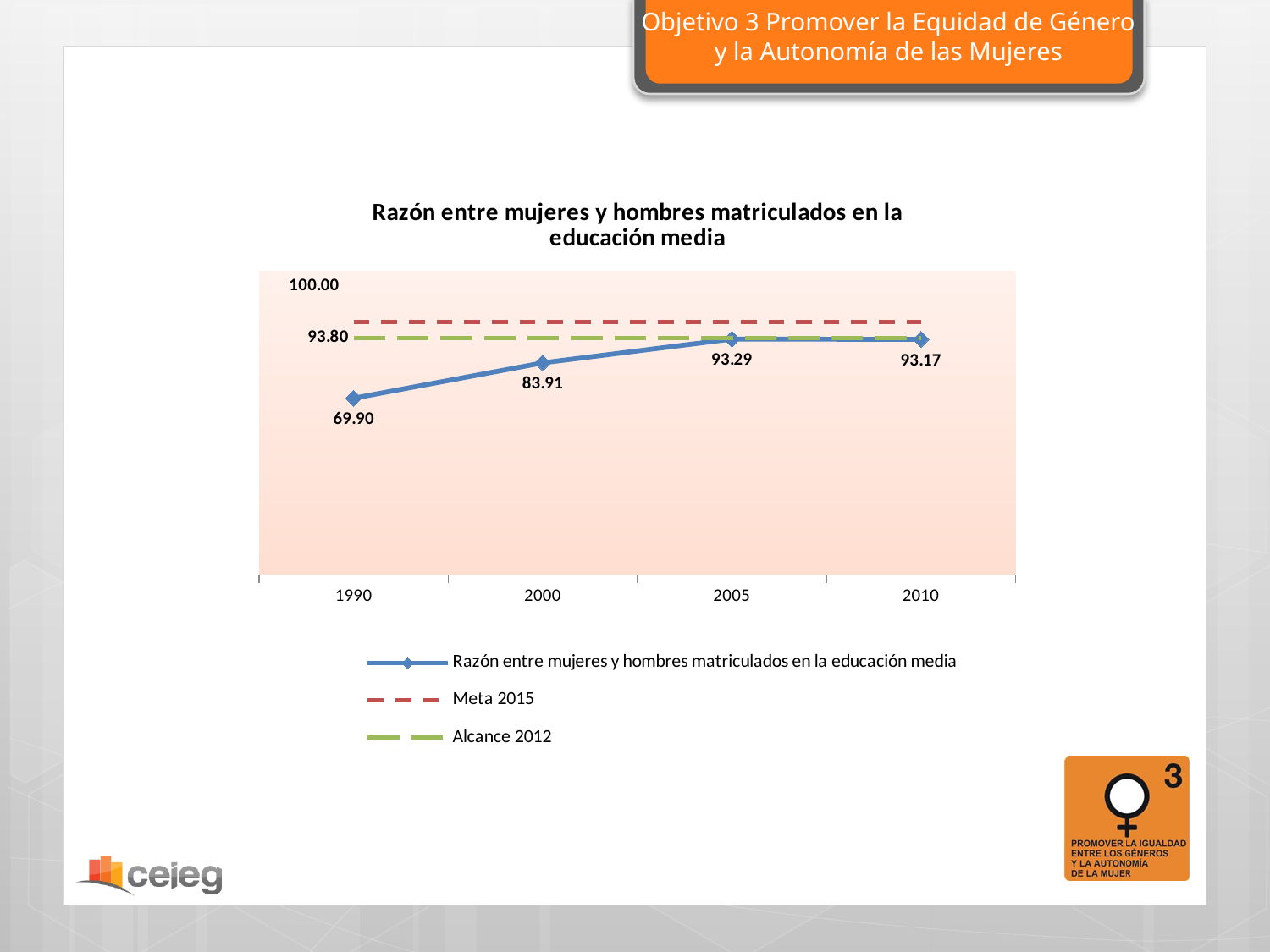
How many series does the legend list? 3 What is the value of the ratio of women to men enrolled in secondary education in 1990? 69.90 What is the value of the ratio of women to men enrolled in secondary education in 2005? 93.29 What value is shown for the Meta 2015 line? 100.00 What is the value of the ratio of women to men enrolled in secondary education in 2010? 93.17 In which year is the ratio of women to men enrolled in secondary education lowest? 1990 What is the title of the chart? Razón entre mujeres y hombres matriculados en la educación media How many years are shown on the x axis? 4 What type of chart is shown on the slide? line chart What value is shown for the Alcance 2012 line? 93.80 What is the value of the ratio of women to men enrolled in secondary education in 2000? 83.91 What is the difference between the ratio in 2000 and the ratio in 1990? 14.01